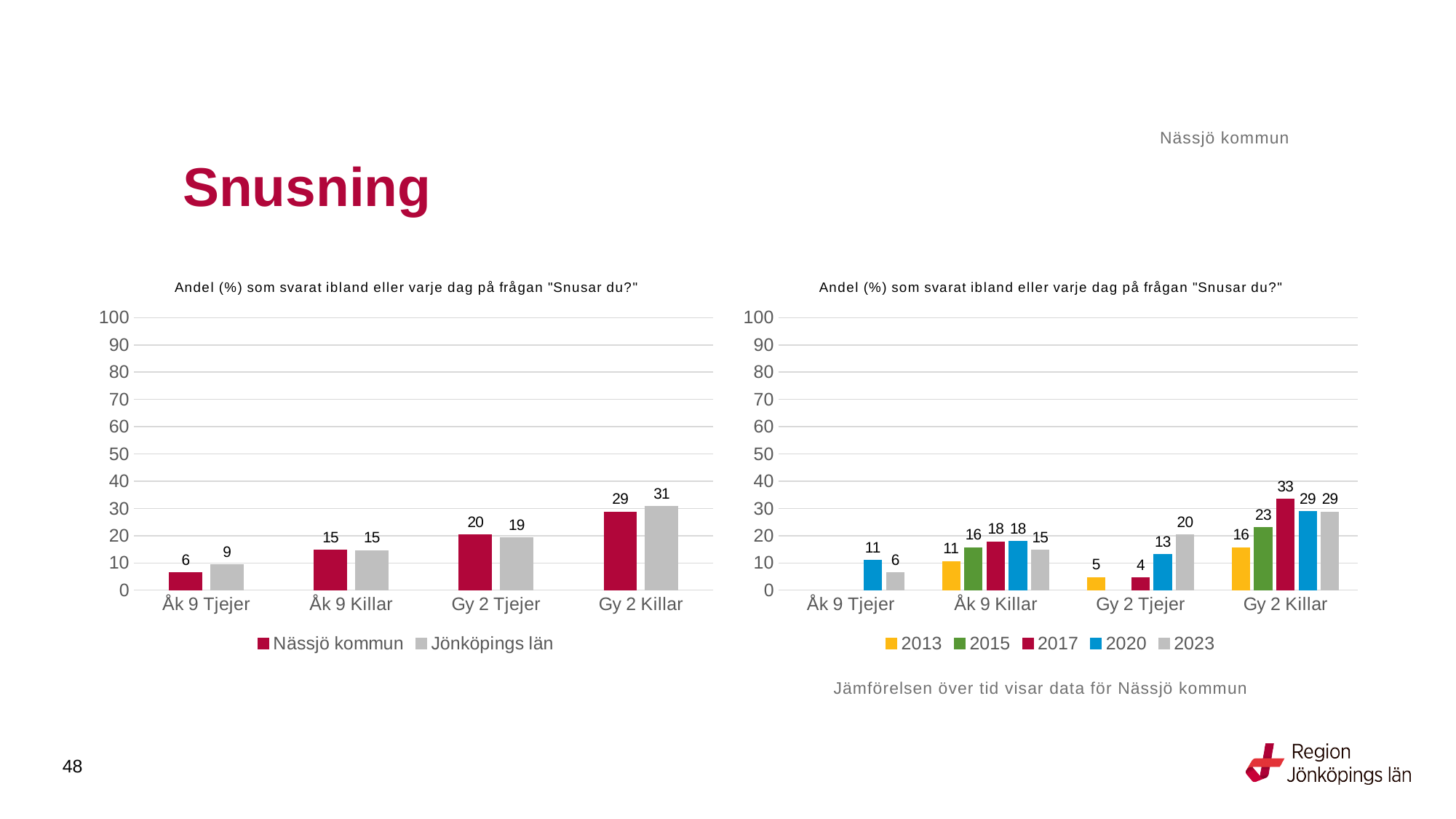
In the right chart, what is the value for 2023 for Gy 2 Tjejer? 20 What kind of chart is the right chart? Bar chart In the left chart, what is the value for Jönköpings län for Åk 9 Tjejer? 9 In the right chart, what is the difference between the 2023 and 2020 values for Åk 9 Tjejer? 5 In the right chart, which year has the lowest value for Gy 2 Tjejer? 2017 In the left chart, what is the value for Nässjö kommun for Gy 2 Killar? 29 How many series does the legend of the left chart list? 2 In the left chart, what is the difference between Jönköpings län and Nässjö kommun for Gy 2 Killar? 2 How many series does the legend of the right chart list? 5 In the left chart, which is larger for Gy 2 Tjejer: Nässjö kommun or Jönköpings län? Nässjö kommun In the left chart, which category has the highest value for Jönköpings län? Gy 2 Killar In the right chart, what is the value for 2017 for Gy 2 Killar? 33